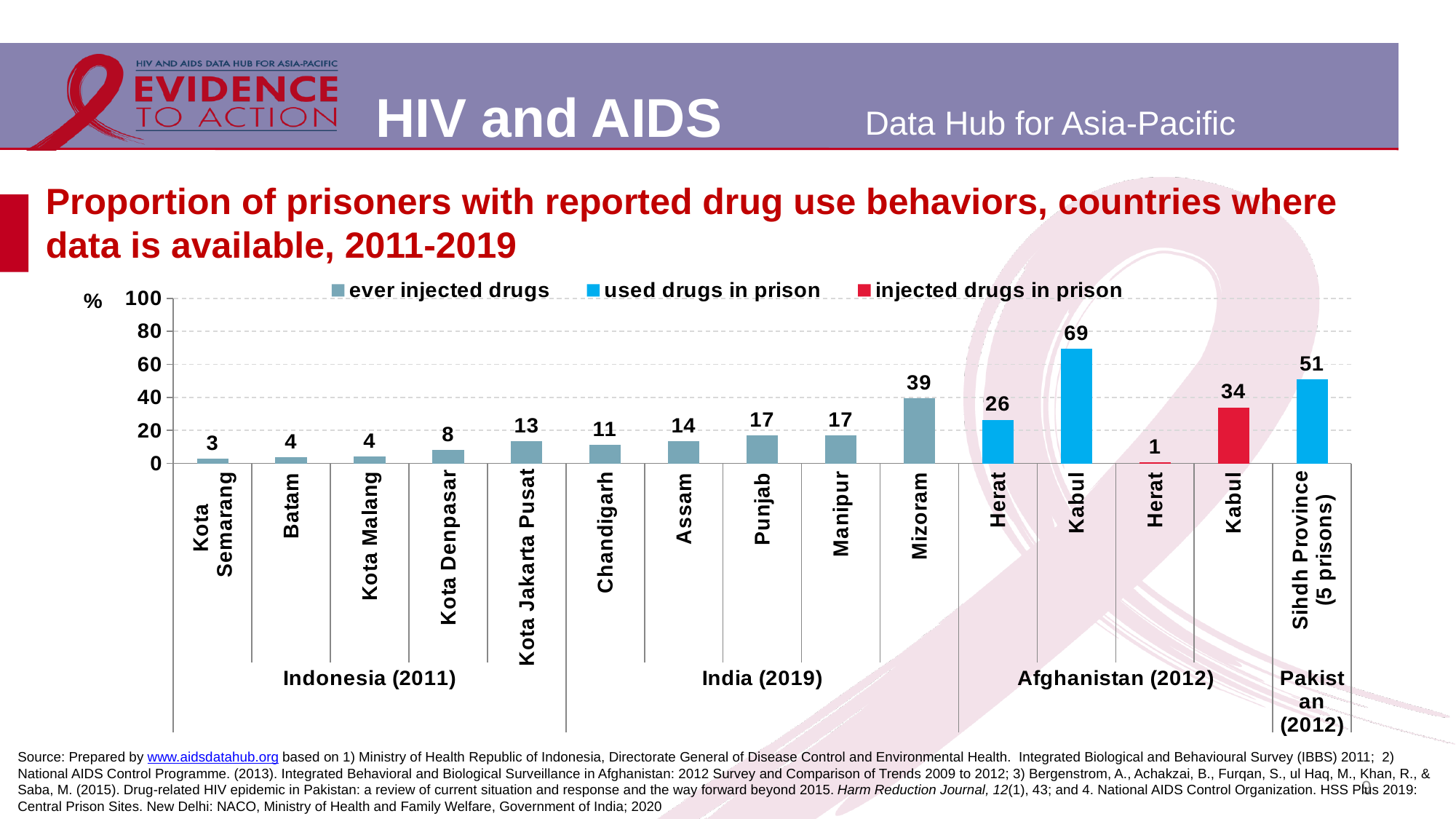
What is the value for the Pakistan (2012) bar (Sindh Province, 5 prisons)? 51 Which bar has the lowest value on the chart? Herat (injected drugs in prison), 1 How many series does the legend list? 3 Which bar has the highest value on the chart? Kabul (used drugs in prison), 69 What kind of chart is shown on the slide? Bar chart What is the difference between the values for Mizoram and Chandigarh? 28 How many sites are shown under Indonesia (2011)? 5 What is the difference between Kabul's 'used drugs in prison' value and Kabul's 'injected drugs in prison' value? 35 What is the value for Mizoram? 39 What is the value for Kabul in the 'used drugs in prison' series? 69 Do the values for the Indonesia (2011) sites rise or fall from left to right? Rise Which is larger: the value for Mizoram or the value for Herat in the 'used drugs in prison' series? Mizoram